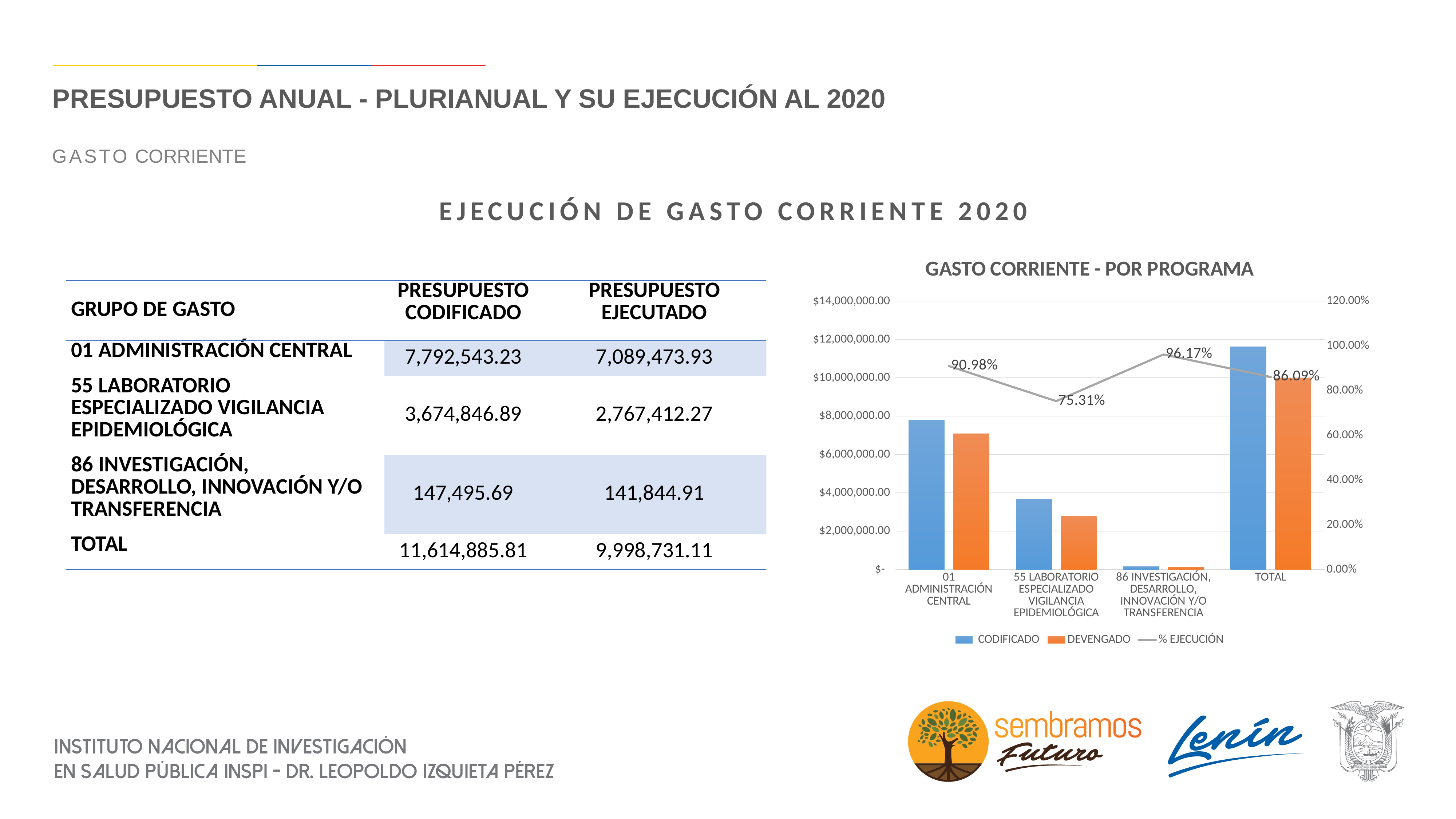
How many series does the legend of the 'GASTO CORRIENTE - POR PROGRAMA' chart list? 3 In the 'GASTO CORRIENTE - POR PROGRAMA' chart, which category has the lowest % EJECUCIÓN? 55 LABORATORIO ESPECIALIZADO VIGILANCIA EPIDEMIOLÓGICA In the 'GASTO CORRIENTE - POR PROGRAMA' chart, what is the % EJECUCIÓN for TOTAL? 86.09% In the 'GASTO CORRIENTE - POR PROGRAMA' chart, what is the difference in % EJECUCIÓN between 86 INVESTIGACIÓN, DESARROLLO, INNOVACIÓN Y/O TRANSFERENCIA and 55 LABORATORIO ESPECIALIZADO VIGILANCIA EPIDEMIOLÓGICA? 20.86 percentage points In the 'GASTO CORRIENTE - POR PROGRAMA' chart, what is the % EJECUCIÓN for 55 LABORATORIO ESPECIALIZADO VIGILANCIA EPIDEMIOLÓGICA? 75.31% In the 'GASTO CORRIENTE - POR PROGRAMA' chart, is the DEVENGADO value for 55 LABORATORIO ESPECIALIZADO VIGILANCIA EPIDEMIOLÓGICA greater or less than $4,000,000.00? less What kind of chart is 'GASTO CORRIENTE - POR PROGRAMA'? bar chart with a line How many categories are shown on the x axis of the 'GASTO CORRIENTE - POR PROGRAMA' chart? 4 In the 'GASTO CORRIENTE - POR PROGRAMA' chart, which is larger for 01 ADMINISTRACIÓN CENTRAL, CODIFICADO or DEVENGADO? CODIFICADO In the 'GASTO CORRIENTE - POR PROGRAMA' chart, is the CODIFICADO value for 01 ADMINISTRACIÓN CENTRAL greater or less than $6,000,000.00? greater In the 'GASTO CORRIENTE - POR PROGRAMA' chart, what is the % EJECUCIÓN for 01 ADMINISTRACIÓN CENTRAL? 90.98% In the 'GASTO CORRIENTE - POR PROGRAMA' chart, which category has the highest % EJECUCIÓN? 86 INVESTIGACIÓN, DESARROLLO, INNOVACIÓN Y/O TRANSFERENCIA